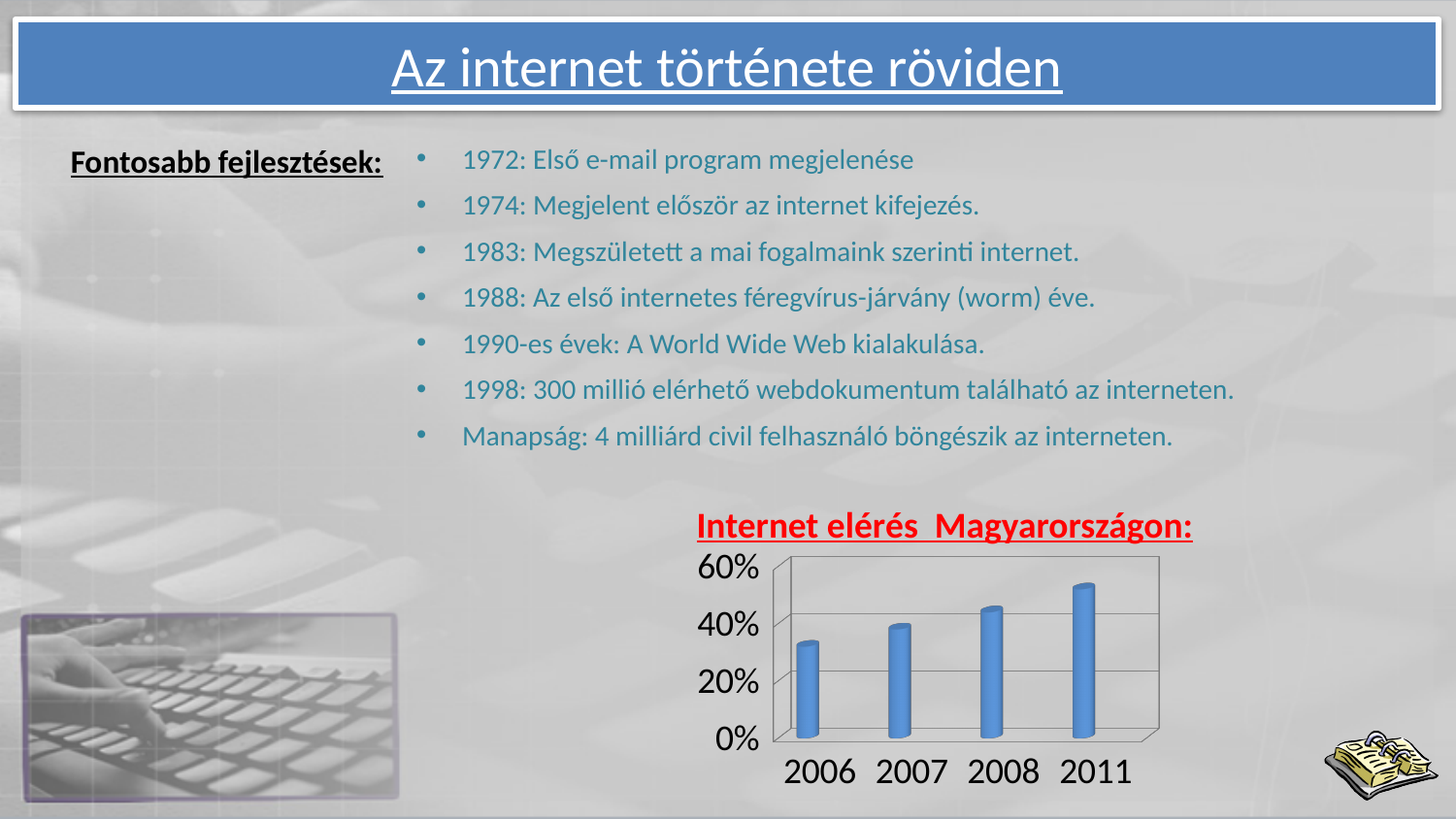
Is the value for 2011 greater or less than 40%? greater Is the value for 2006 greater or less than 40%? less Which is larger, the value for 2008 or the value for 2006? 2008 Which year has the lowest bar in the chart? 2006 What kind of chart is shown on the slide? bar chart Which year has the highest bar in the chart? 2011 Is the value for 2006 greater or less than 20%? greater Do the values in the chart rise or fall from 2006 to 2011? rise Which is larger, the value for 2011 or the value for 2006? 2011 What is the title of the chart on the slide? Internet elérés Magyarországon: How many years are shown on the x axis of the chart? 4